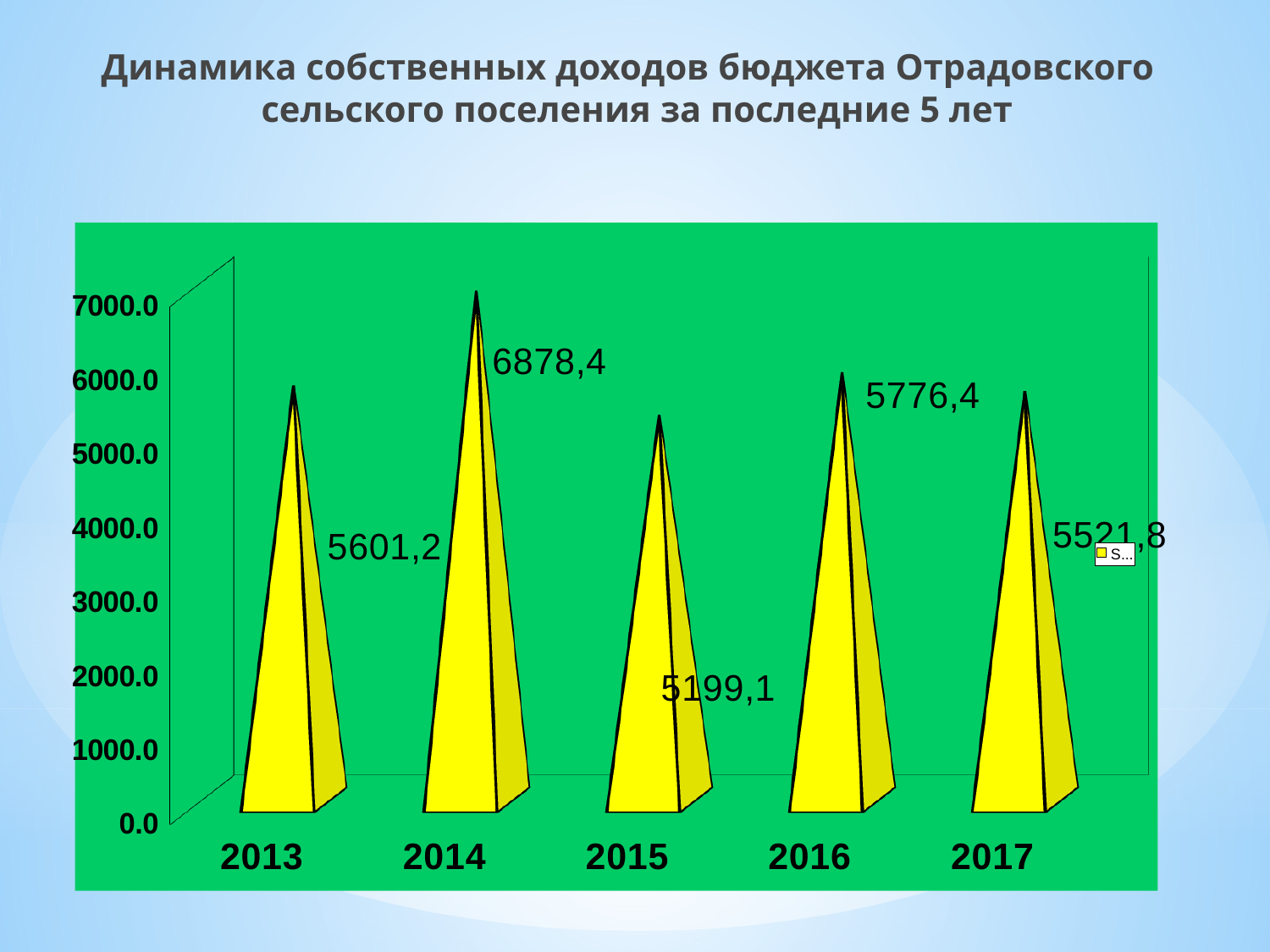
What is the difference between the values for 2014 and 2013? 1277,2 How many years are shown on the x axis? 5 Does the value rise or fall from 2014 to 2015? fall What is the value shown for 2014? 6878,4 What is the value shown for 2015? 5199,1 Which year has the lowest value? 2015 What kind of chart is shown on the slide? bar chart Is the value for 2016 greater or less than 5000.0? greater Which is larger, the value for 2013 or the value for 2017? 2013 What is the difference between the values for 2016 and 2015? 577,3 Which year has the highest value? 2014 What is the value shown for 2017? 5521,8